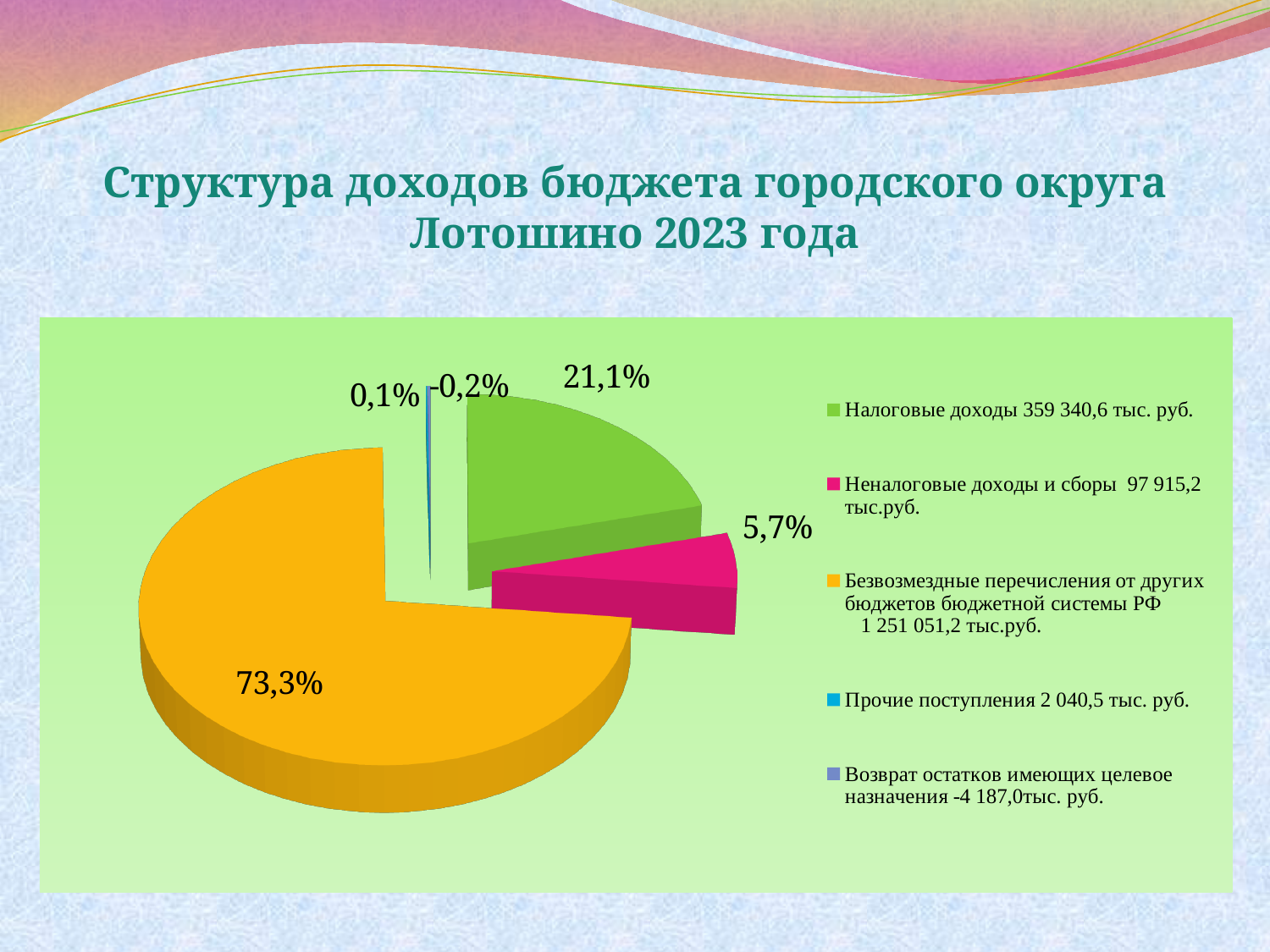
What percentage is shown for Неналоговые доходы и сборы? 5,7% Which category has the largest share of the pie? Безвозмездные перечисления от других бюджетов бюджетной системы РФ What is the smallest percentage label shown on the pie chart? 0,1% What percentage of the budget revenue is shown for Налоговые доходы? 21,1% How many categories does the legend list? 5 What type of chart is shown on the slide? Pie chart According to the legend, what amount is given for Налоговые доходы? 359 340,6 тыс. руб. What is the difference in percentage points between Безвозмездные перечисления (73,3%) and Налоговые доходы (21,1%)? 52,2 What percentage is shown for Безвозмездные перечисления от других бюджетов бюджетной системы РФ? 73,3% What is the difference in percentage points between Налоговые доходы (21,1%) and Неналоговые доходы и сборы (5,7%)? 15,4 What is the title of the slide? Структура доходов бюджета городского округа Лотошино 2023 года Which has a larger share: Налоговые доходы or Неналоговые доходы и сборы? Налоговые доходы